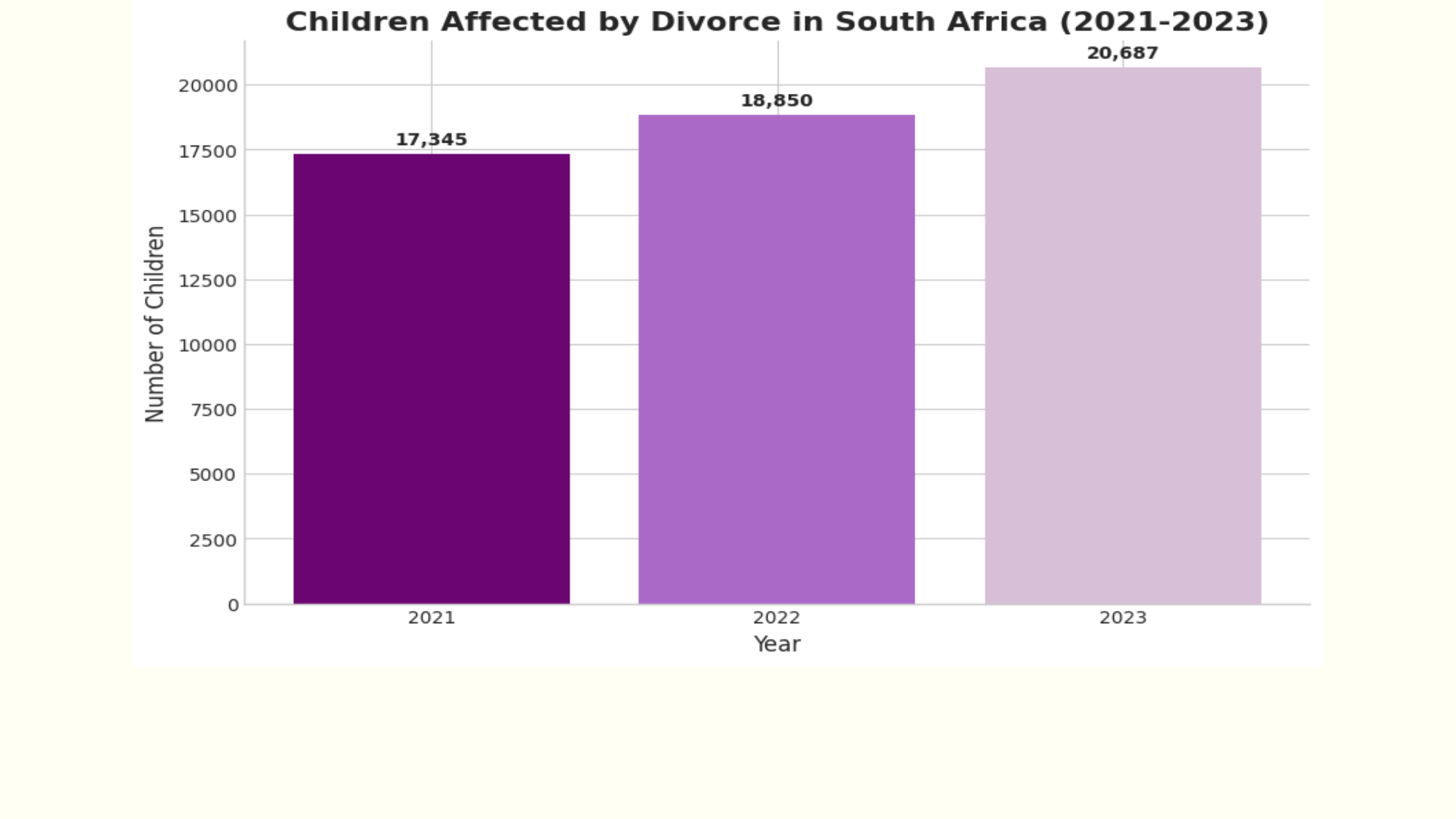
What is the number of children affected by divorce in 2022? 18,850 What is the difference between the number of children affected in 2023 and in 2021? 3,342 How many years are shown on the x axis? 3 Is the value for 2023 greater or less than 20000? greater Which year has a larger value, 2022 or 2023? 2023 What kind of chart is shown on the slide? Bar chart What is the number of children affected by divorce in 2021? 17,345 What is the number of children affected by divorce in 2023? 20,687 Which year has the highest number of children affected by divorce? 2023 Which year has the lowest number of children affected by divorce? 2021 Do the values rise or fall from 2021 to 2023? Rise What is the difference between the number of children affected in 2022 and in 2021? 1,505